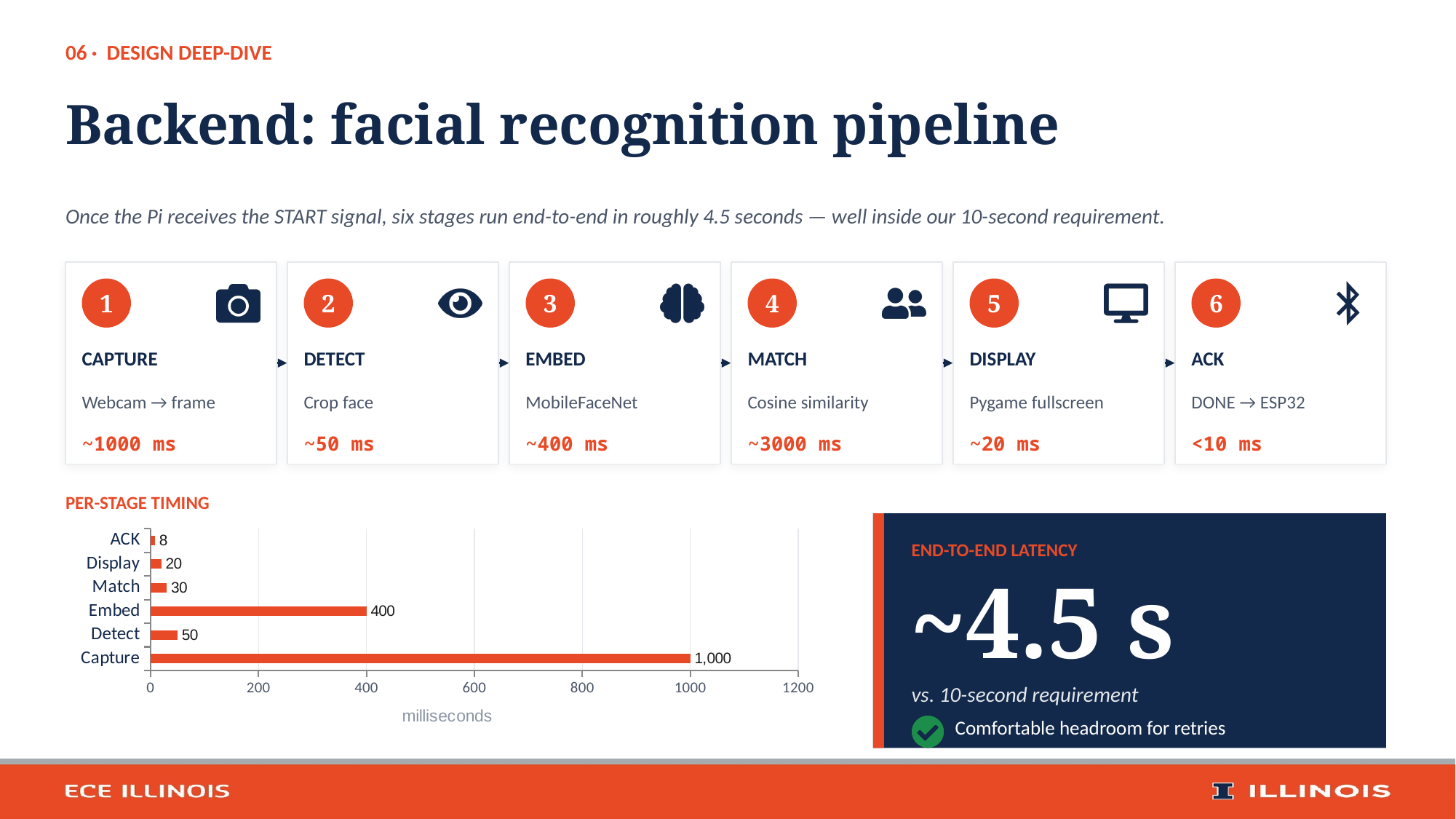
In the Per-Stage Timing chart, which stage has the lowest value? ACK In the Per-Stage Timing chart, which stage has the highest value? Capture What is the x-axis label of the Per-Stage Timing chart? milliseconds In the Per-Stage Timing chart, what is the value for Match? 30 What kind of chart is the Per-Stage Timing chart? bar chart In the Per-Stage Timing chart, what is the value for ACK? 8 How many stages are plotted in the Per-Stage Timing chart? 6 In the Per-Stage Timing chart, is the value for Embed greater or less than 600? less In the Per-Stage Timing chart, what is the difference between the Capture and Embed values? 600 In the Per-Stage Timing chart, what is the value for Embed? 400 In the Per-Stage Timing chart, what is the value for Capture? 1,000 In the Per-Stage Timing chart, which is larger, Detect or Display? Detect